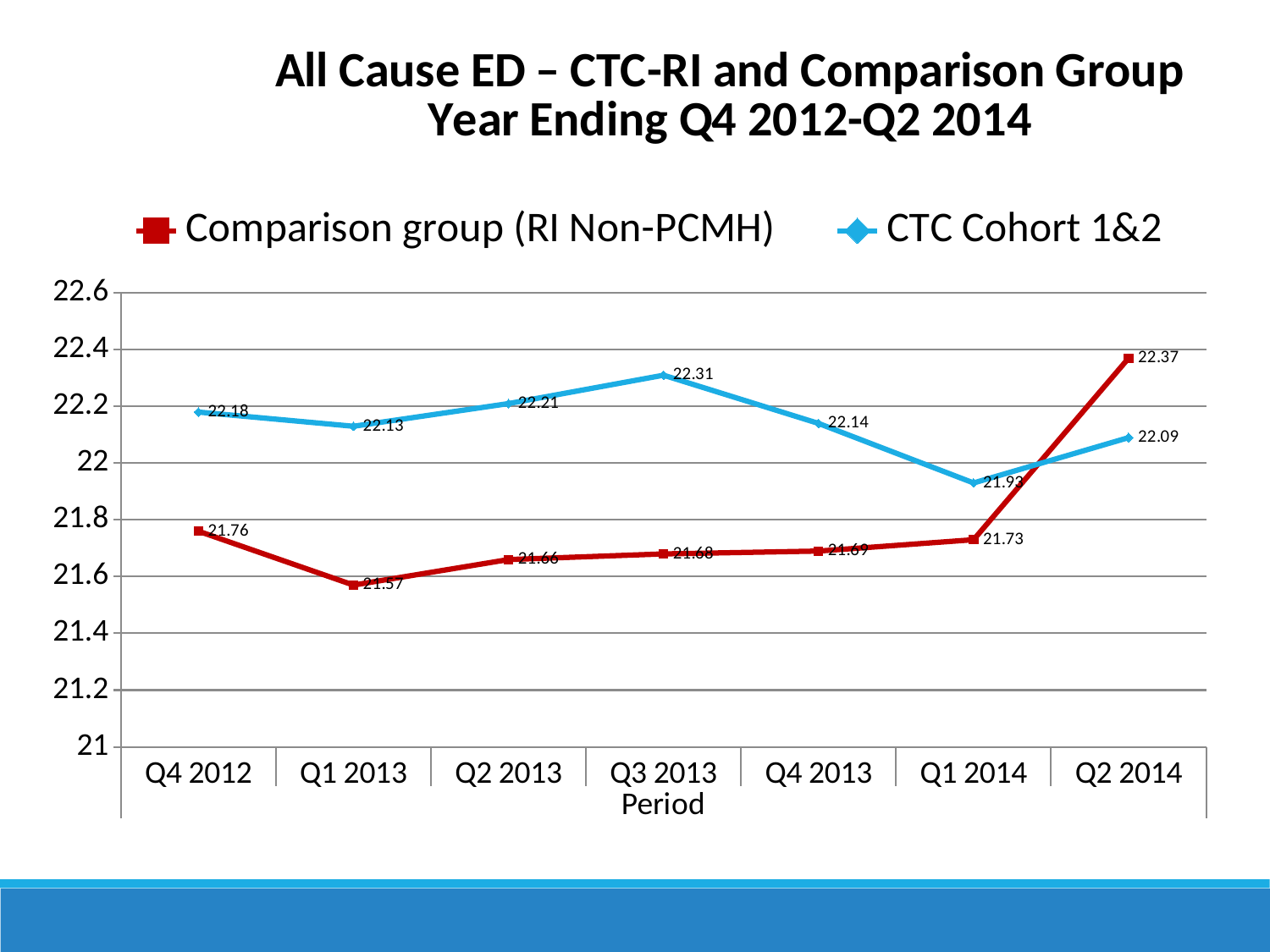
What kind of chart is shown on the slide? line chart How many series does the legend list? 2 What is the value for the Comparison group (RI Non-PCMH) in Q1 2013? 21.57 Is the value for CTC Cohort 1&2 in Q1 2014 greater or less than 22? less In which period does the Comparison group (RI Non-PCMH) reach its highest value? Q2 2014 In which period does the Comparison group (RI Non-PCMH) have its lowest value? Q1 2013 What is the value for the Comparison group (RI Non-PCMH) in Q2 2014? 22.37 What is the value for CTC Cohort 1&2 in Q3 2013? 22.31 In Q4 2012, which series has the higher value, Comparison group (RI Non-PCMH) or CTC Cohort 1&2? CTC Cohort 1&2 How many periods are shown on the x axis? 7 In which period does CTC Cohort 1&2 reach its highest value? Q3 2013 What is the difference between the Comparison group (RI Non-PCMH) and CTC Cohort 1&2 values in Q2 2014? 0.28